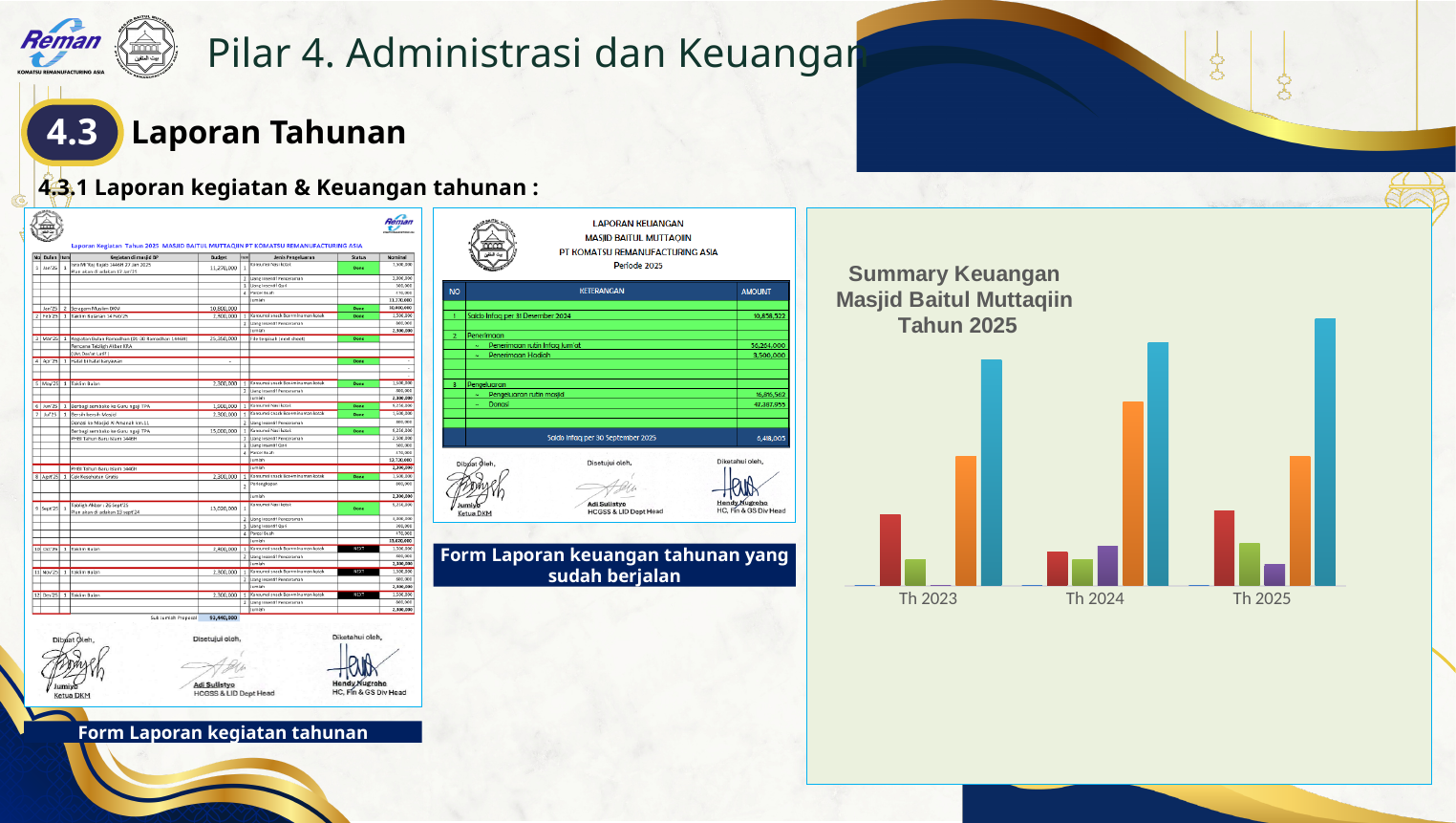
In the 'Summary Keuangan' chart, do the teal bars rise or fall from Th 2023 to Th 2025? Rise What is the title of the bar chart on the right side of the slide? Summary Keuangan Masjid Baitul Muttaqiin Tahun 2025 In the 'Summary Keuangan' chart, which year has the tallest orange bar? Th 2024 In the 'Summary Keuangan' chart, is the green bar taller for Th 2023 or for Th 2025? Th 2025 In the 'Summary Keuangan' chart, which year has the tallest teal bar? Th 2025 In the 'Summary Keuangan' chart, for Th 2024, is the orange bar or the red bar taller? Orange bar What are the category labels on the x axis of the 'Summary Keuangan' chart? Th 2023, Th 2024, Th 2025 In the 'Summary Keuangan' chart, which colour bar is the tallest in every year group? Teal In the 'Summary Keuangan' chart, is the purple bar taller for Th 2024 or for Th 2025? Th 2024 What kind of chart is the 'Summary Keuangan Masjid Baitul Muttaqiin Tahun 2025' chart? Bar chart How many year categories are shown on the x axis of the 'Summary Keuangan Masjid Baitul Muttaqiin Tahun 2025' chart? 3